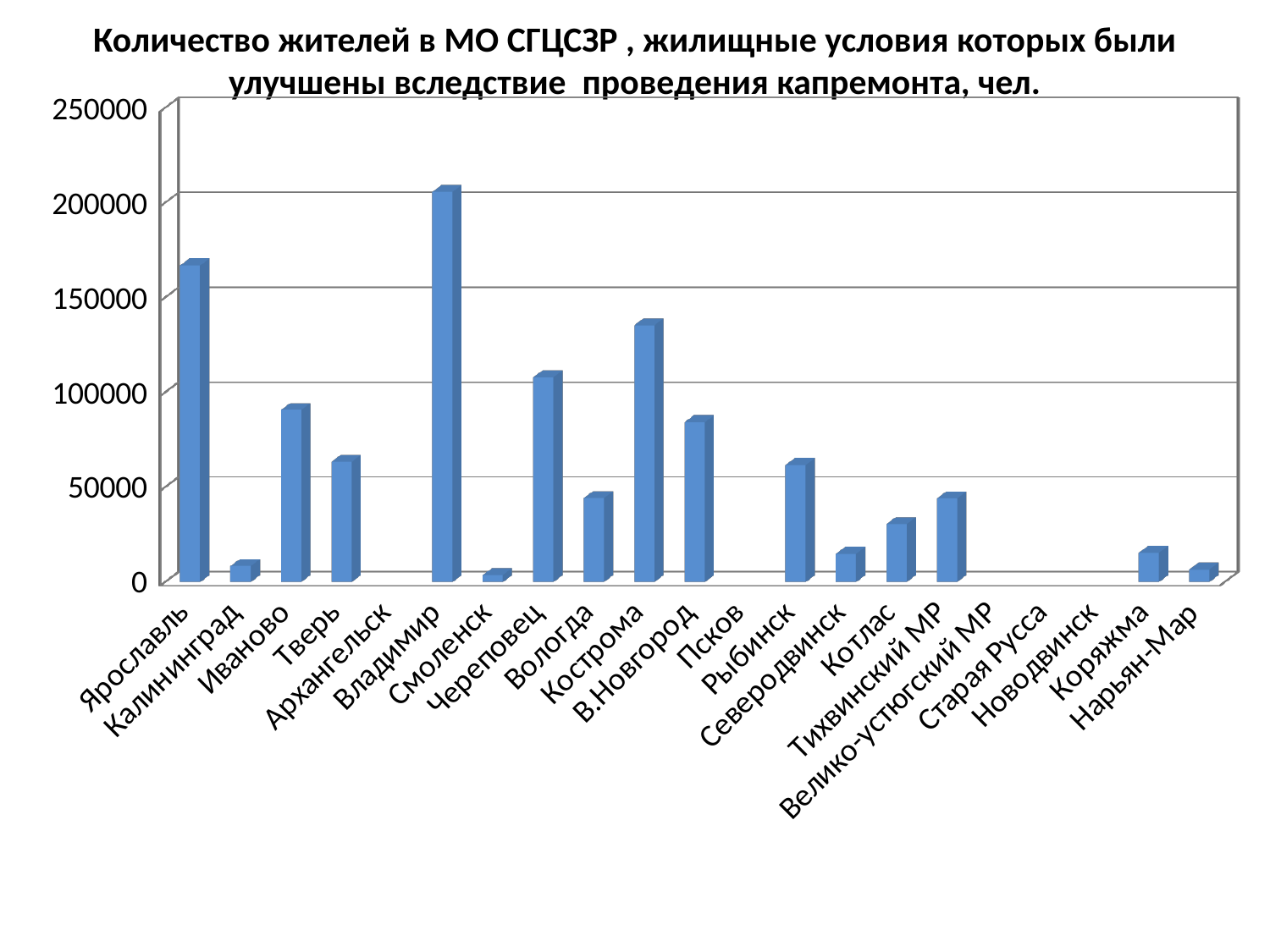
Is the value for Тверь greater or less than 50000? greater Is the value for Иваново greater or less than 100000? less Which has a larger value, Иваново or Тверь? Иваново What kind of chart is shown on the slide? bar chart Is the value for Ярославль greater or less than 150000? greater Which has a larger value, Ярославль or Кострома? Ярославль What is the highest value shown on the vertical axis of the chart? 250000 Which city has the highest number of residents whose housing conditions were improved? Владимир Which has a larger value, Владимир or Ярославль? Владимир How many cities/districts are shown along the x axis of the chart? 21